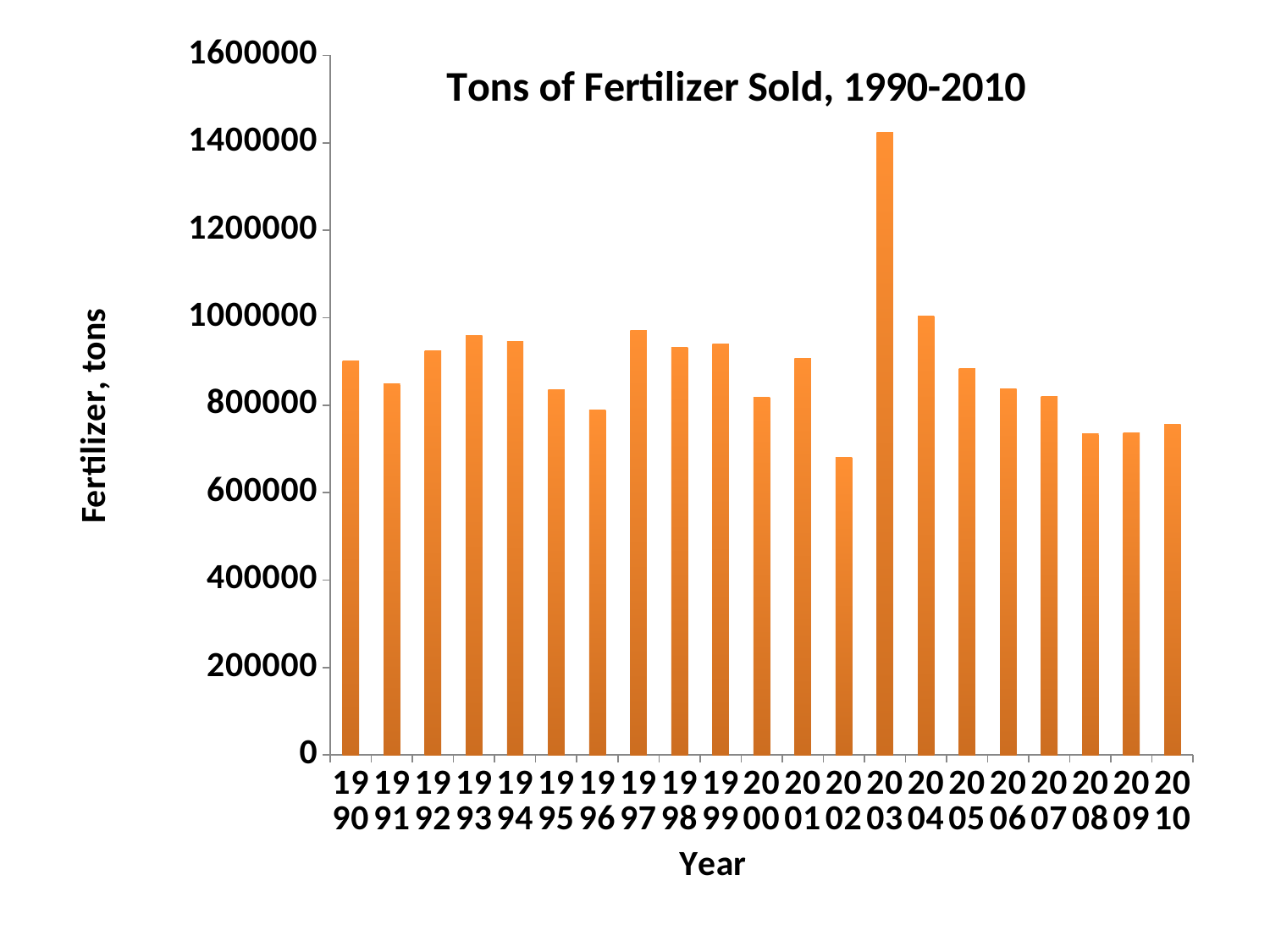
What is the label on the vertical axis of the chart? Fertilizer, tons Is the value for 2008 greater or less than 800000? less What is the title of the chart? Tons of Fertilizer Sold, 1990-2010 Which year has the lowest tons of fertilizer sold? 2002 How many years (bars) are plotted in the chart? 21 Is the value for 2003 greater or less than 1200000? greater Is the value for 2002 greater or less than 800000? less What kind of chart is shown on the slide? Bar chart Which year had more fertilizer sold, 2003 or 2004? 2003 Which year has the highest tons of fertilizer sold? 2003 Which year had more fertilizer sold, 1996 or 1997? 1997